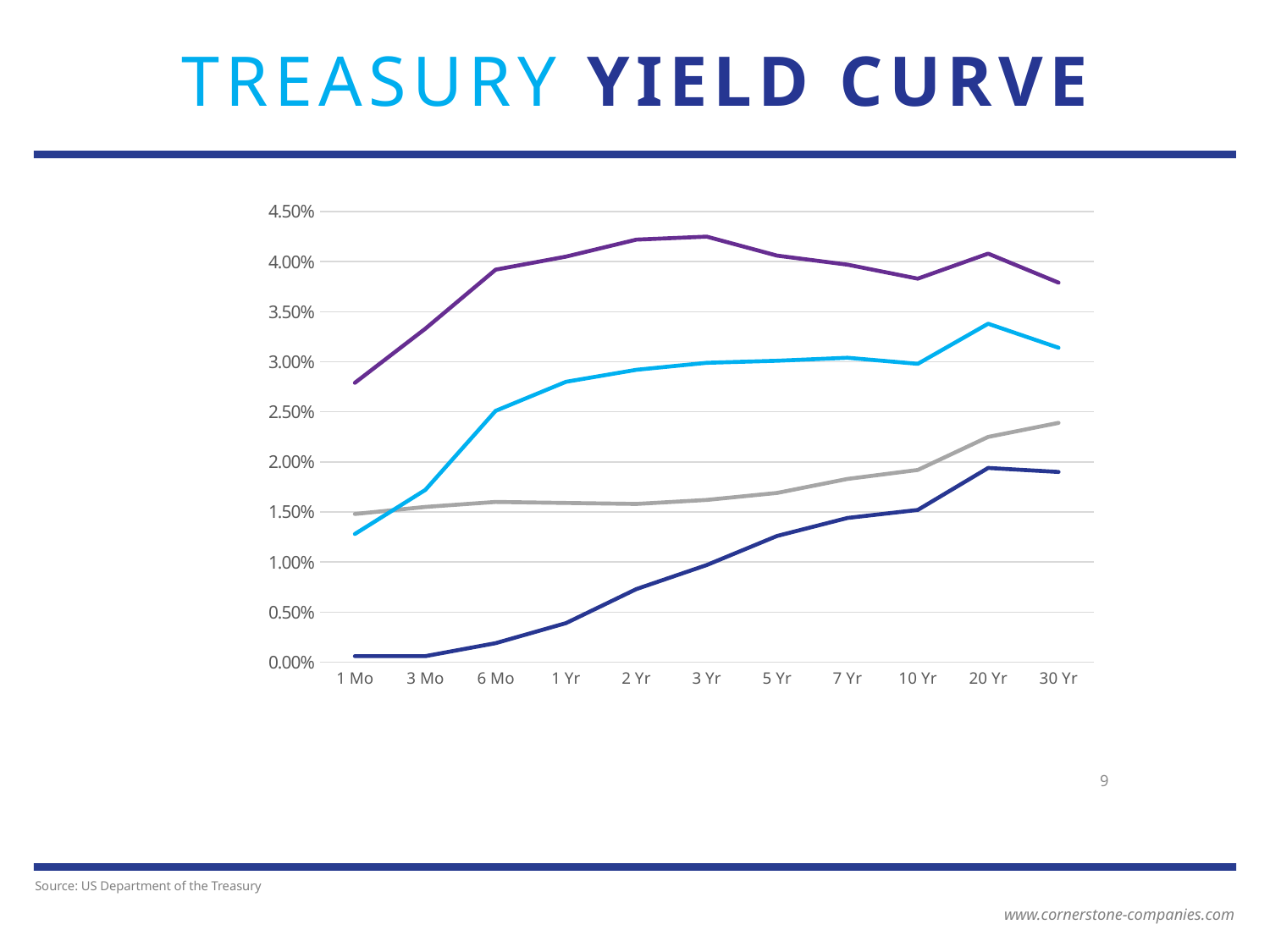
At which maturity does the light blue line reach its highest value? 20 Yr Is the value of the dark blue line at 1 Mo greater or less than 0.50%? less What kind of chart is shown on the slide? line chart At which maturity does the purple line have its lowest value? 1 Mo Is the value of the gray line at 20 Yr greater or less than 2.00%? greater At 30 Yr, which line is higher: the gray line or the dark blue line? gray line Is the value of the purple line at 1 Mo greater or less than 3.00%? less What is the title of the slide containing the chart? Treasury Yield Curve How many maturities are shown along the x axis of the chart? 11 How many lines are plotted on the chart? 4